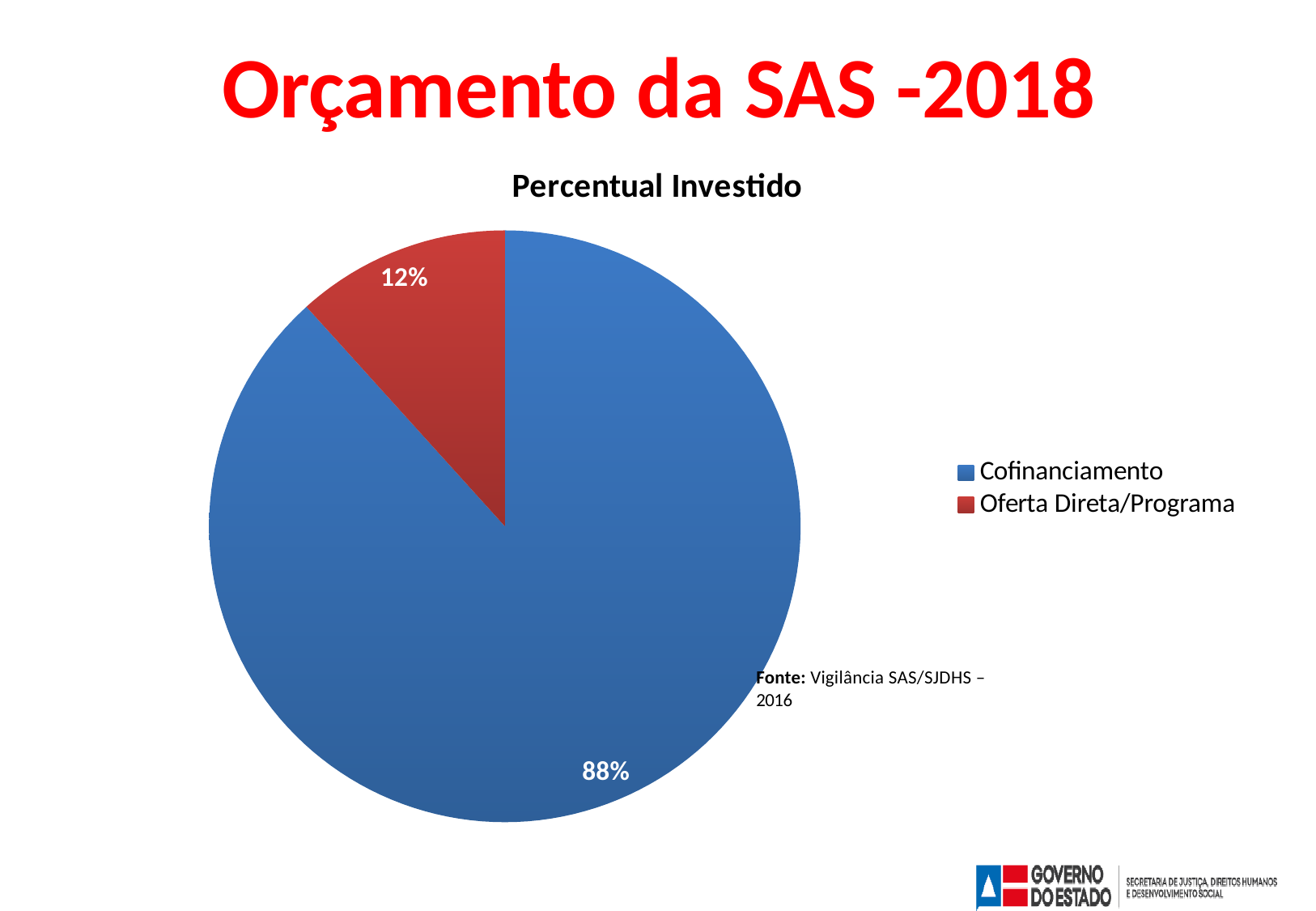
Which is larger, Cofinanciamento or Oferta Direta/Programa? Cofinanciamento Which category has the largest slice of the pie? Cofinanciamento What is the title of the chart? Percentual Investido What share of the pie does Oferta Direta/Programa represent? 12% What is the difference in percentage points between Cofinanciamento and Oferta Direta/Programa? 76 What colour is the Oferta Direta/Programa slice? red How many entries does the legend list? 2 Which category has the smallest slice of the pie? Oferta Direta/Programa What kind of chart is shown on the slide? pie chart What share of the pie does Cofinanciamento represent? 88% How many slices does the pie chart have? 2